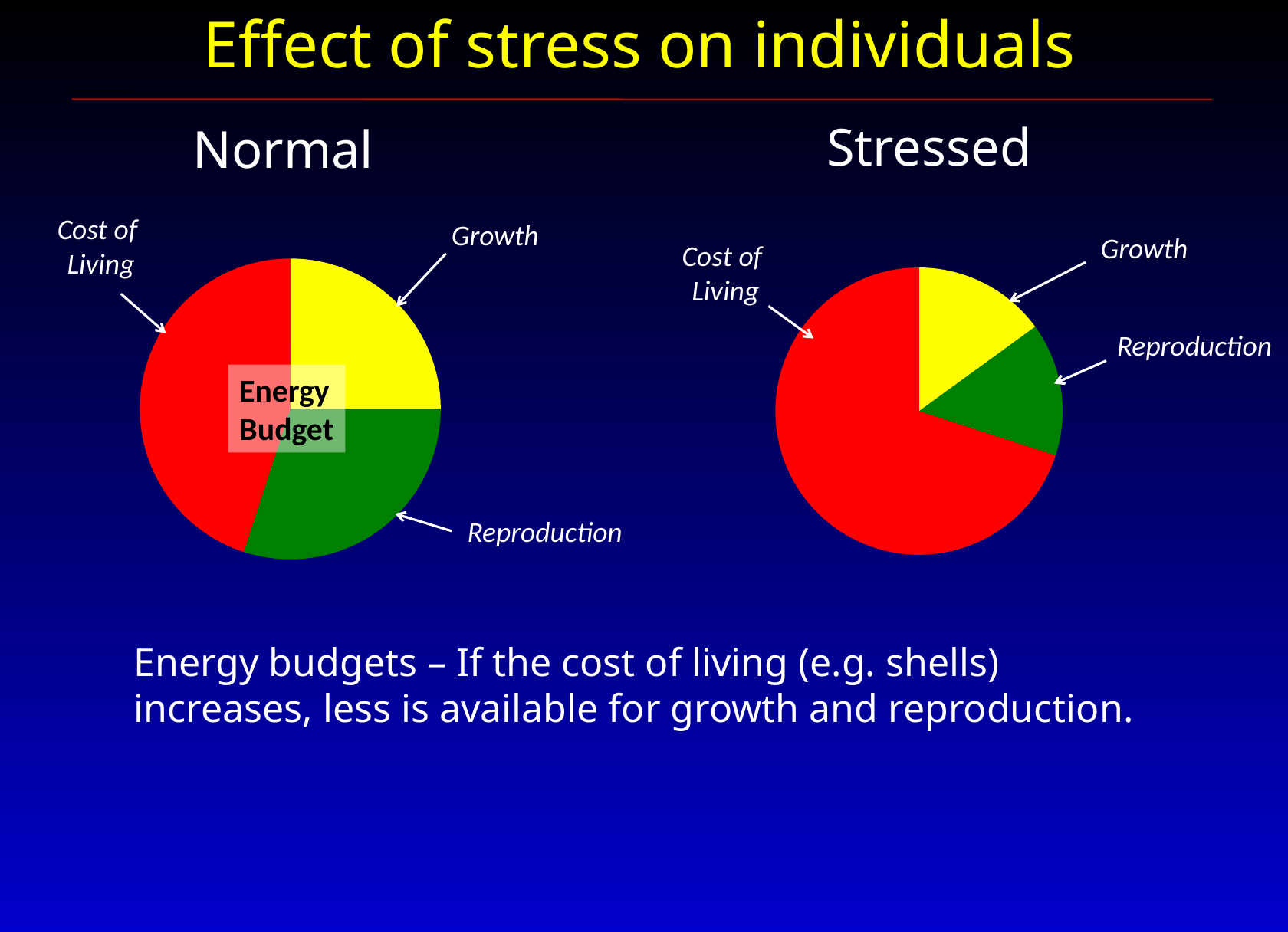
In the Normal pie chart, which category has the largest slice? Cost of Living In the Normal pie chart, which is larger, Cost of Living or Growth? Cost of Living In the Normal pie chart, which is larger, Reproduction or Growth? Reproduction How many slices does the Normal pie chart have? 3 What label is printed in the centre of the Normal pie chart? Energy Budget In the Stressed pie chart, which is larger, Reproduction or Cost of Living? Cost of Living What kind of chart is the Normal chart? pie chart How many slices does the Stressed pie chart have? 3 What colour is the Growth slice in the Normal pie chart? yellow In the Stressed pie chart, which category has the largest slice? Cost of Living What kind of chart is the Stressed chart? pie chart